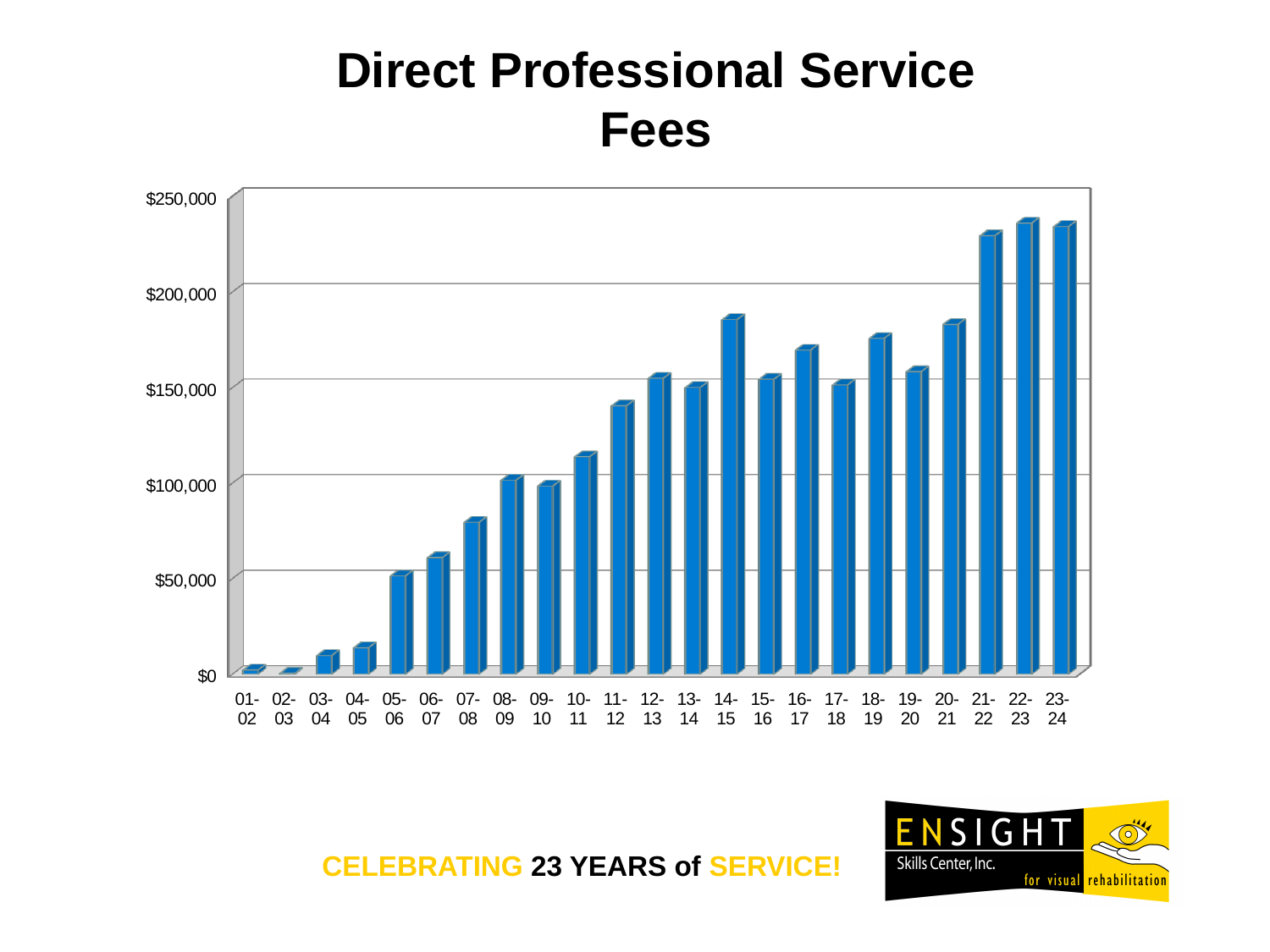
What is the highest value labelled on the y axis of the chart? $250,000 What kind of chart is shown on the slide? bar chart Which is larger, the value for 16-17 or the value for 17-18? 16-17 Is the value for 11-12 greater or less than $150,000? less Is the value for 21-22 greater or less than $200,000? greater Which is larger, the value for 13-14 or the value for 14-15? 14-15 Is the value for 03-04 greater or less than $50,000? less What is the title of the chart? Direct Professional Service Fees Do the values generally rise or fall from 01-02 to 08-09? rise How many fiscal-year categories are shown on the x axis of the chart? 23